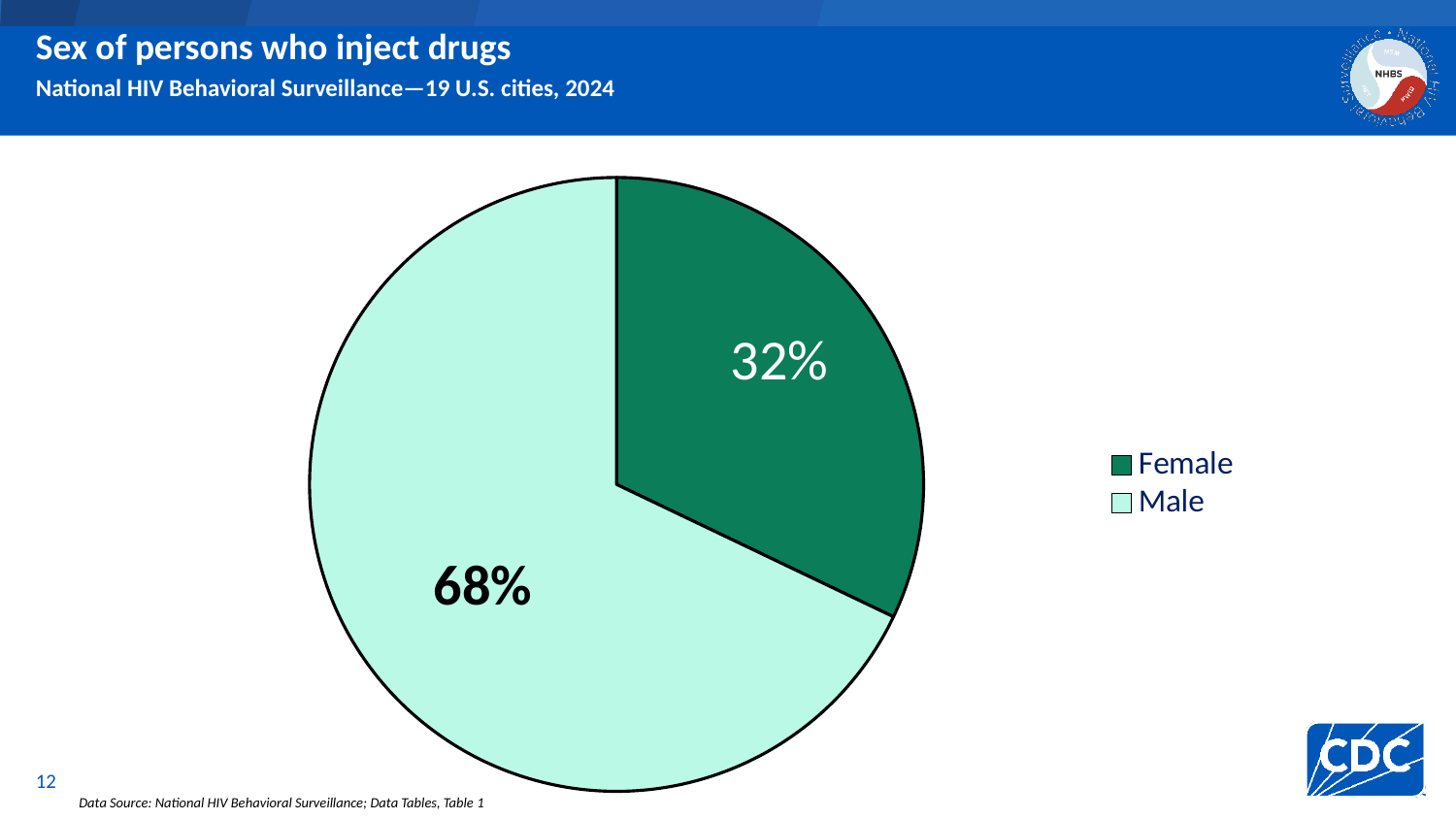
What percentage of persons who inject drugs are female? 32% How many categories are shown in the pie chart? 2 What is the difference in percentage points between the male and female shares? 36 Which is larger, the share of males or the share of females? Male What is the title of the chart? Sex of persons who inject drugs What percentage of persons who inject drugs are male? 68% Which sex category has the largest share of the pie? Male Which category is shown in the darker green colour in the legend? Female Which sex category has the smallest share of the pie? Female What kind of chart is shown on the slide? Pie chart What share of the pie does the Male slice represent? 68%